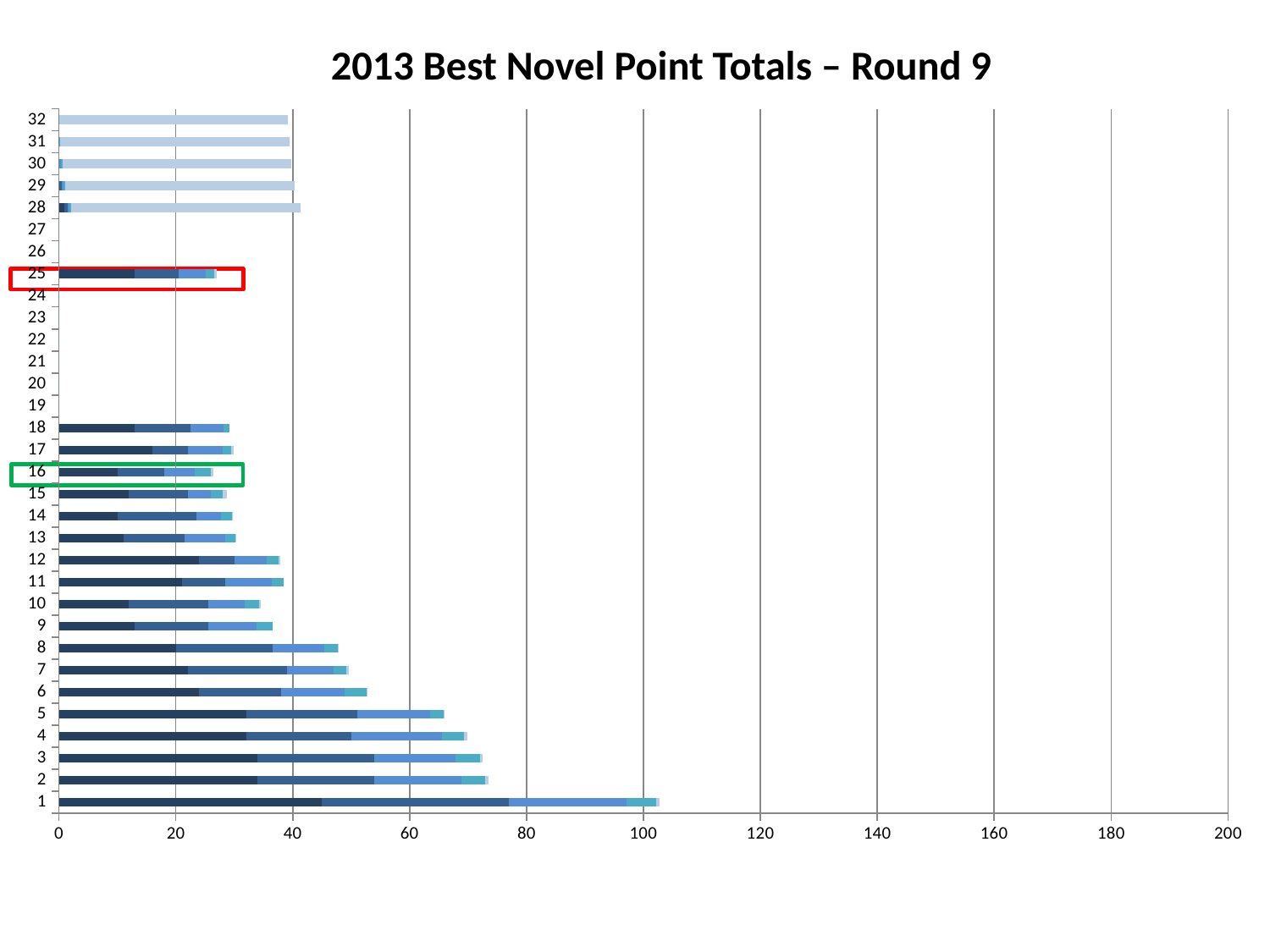
What kind of chart is shown on the slide? bar chart Is the total for category 1 greater or less than 80? greater Is the total for category 6 greater or less than 60? less Which category is outlined with a red box on the chart? 25 Is the total for category 5 greater or less than 60? greater Which category has the longest bar in the chart? 1 What is the title of the chart? 2013 Best Novel Point Totals – Round 9 How many categories are listed on the vertical axis of the chart? 32 Which has the longer bar, category 5 or category 6? 5 Which has the longer bar, category 12 or category 13? 12